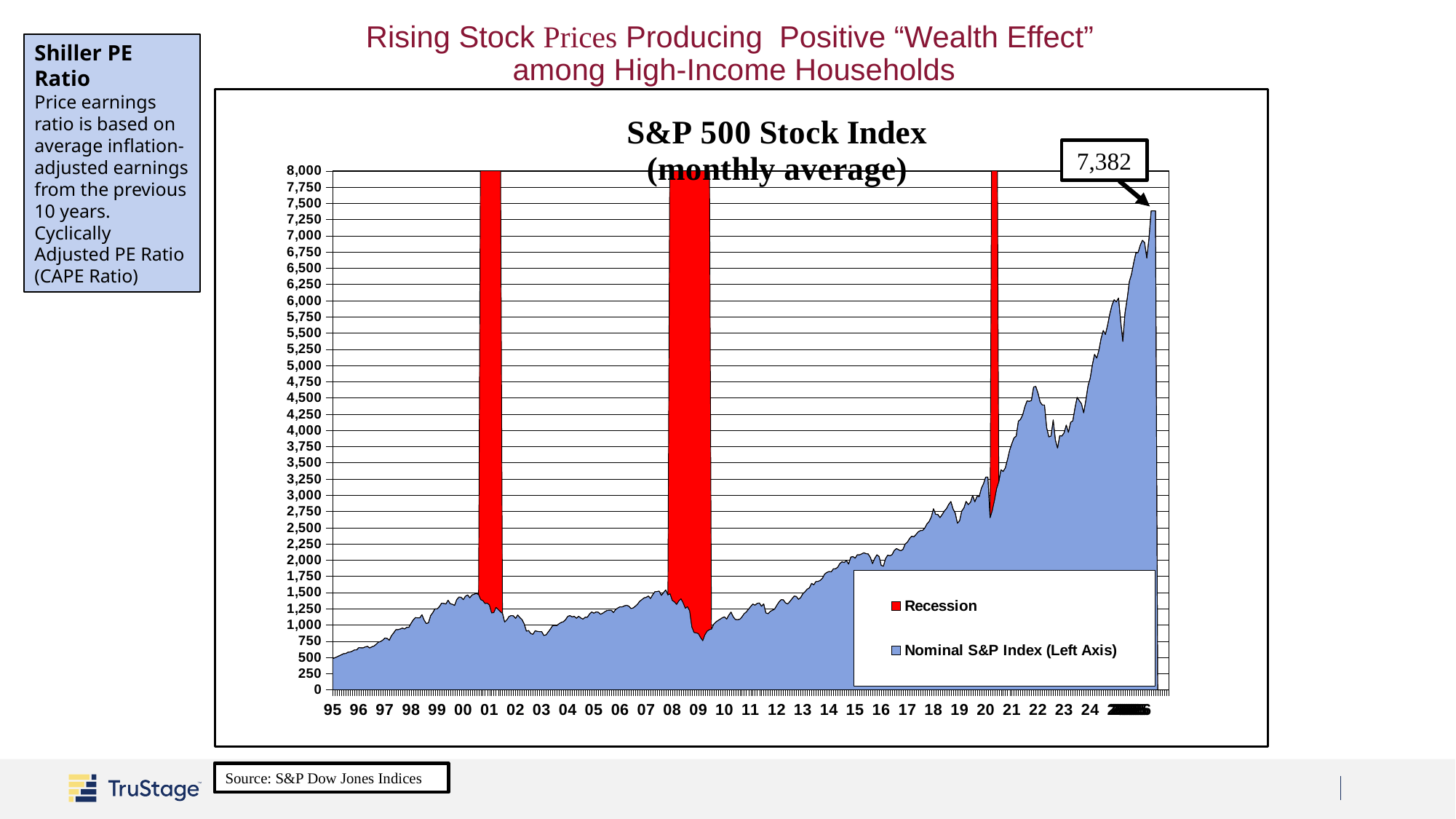
What is the highest value shown on the left axis of the chart? 8,000 Is the lowest value of the Nominal S&P Index during the 08-09 recession greater or less than 1,000? less How many series does the chart legend list? 2 Is the value of the Nominal S&P Index in 95 greater or less than 1,000? less How many recession periods are shaded on the chart? 3 What colour is used for the Recession series in the legend? red What is the title of the chart on the slide? S&P 500 Stock Index (monthly average) What is the most recent value of the S&P 500 index labeled on the chart? 7,382 Does the Nominal S&P Index generally rise or fall from 95 to the end of the chart? rise Is the peak value of the Nominal S&P Index in 22 greater or less than 4,000? greater Which year has a higher Nominal S&P Index value, 05 or 15? 15 What kind of chart is shown on the slide? area chart